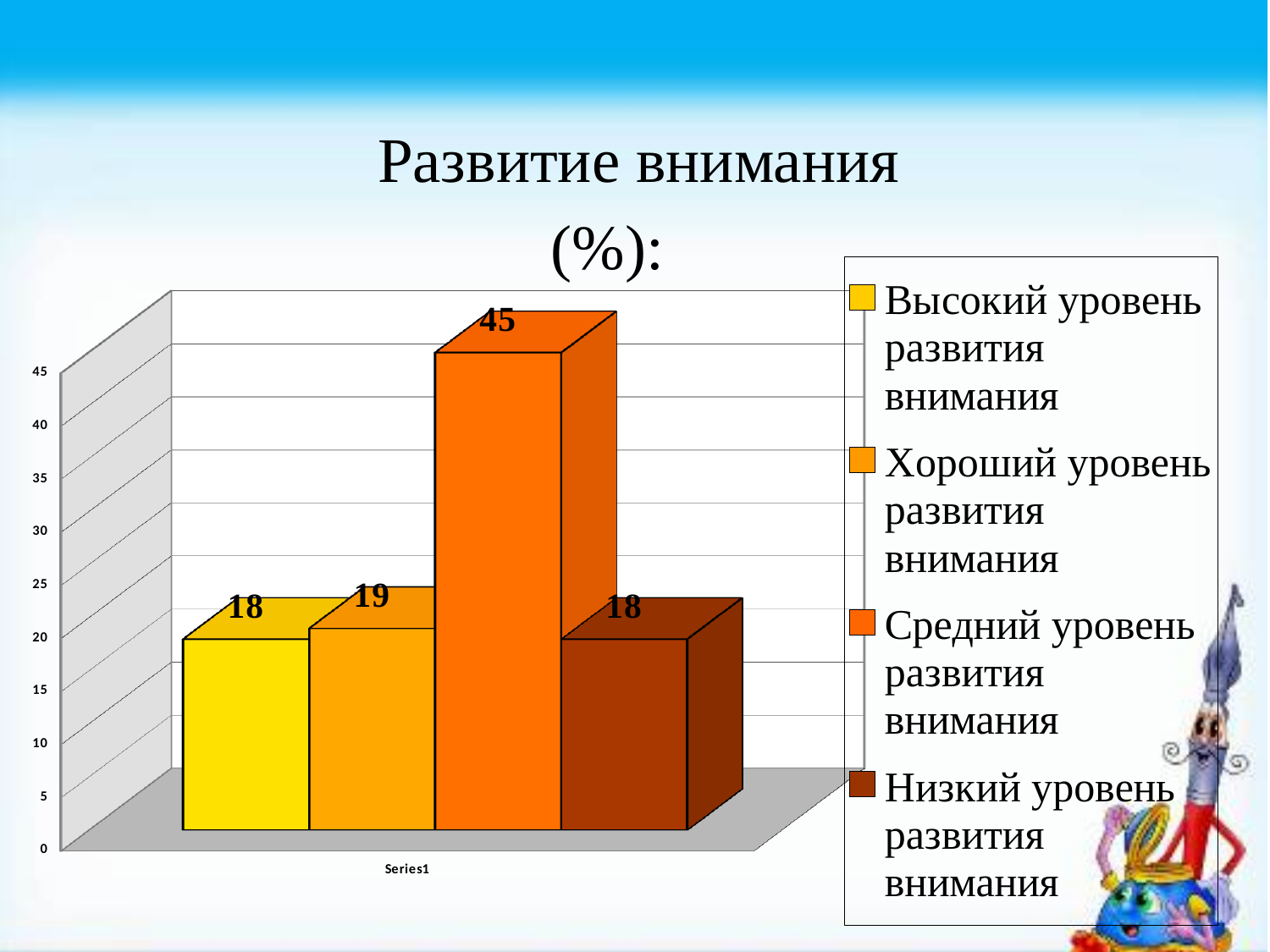
What is the value for Хороший уровень развития внимания? 19 What is the difference between the values for Хороший уровень and Высокий уровень развития внимания? 1 Which level has the highest value? Средний уровень развития внимания What is the value for Средний уровень развития внимания? 45 Which is larger, the value for Средний уровень or the value for Низкий уровень развития внимания? Средний уровень развития внимания Is the value for Средний уровень развития внимания greater or less than 40? greater What is the value for Низкий уровень развития внимания? 18 What is the value for Высокий уровень развития внимания? 18 What is the title of the chart? Развитие внимания (%): What is the difference between the values for Средний уровень and Хороший уровень развития внимания? 26 How many bars are plotted in the chart? 4 What kind of chart is shown on the slide? bar chart